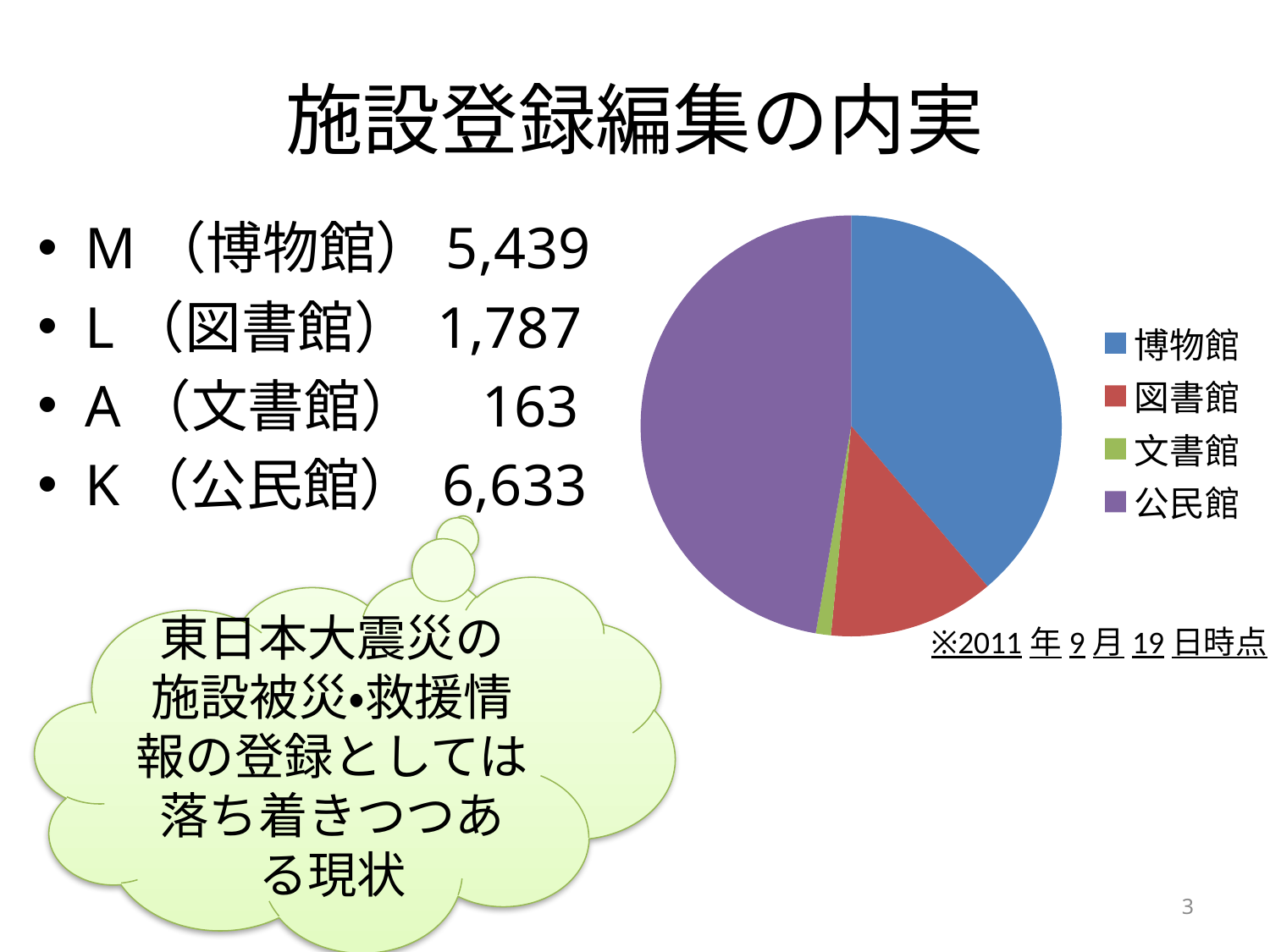
What is the total of the four values shown for the pie chart? 14,022 What colour is the 公民館 slice in the pie chart? purple How many categories does the pie chart's legend list? 4 According to the slide, what is the value for 図書館 (L)? 1,787 What kind of chart is shown on the slide? pie chart Which is larger, the slice for 博物館 or the slice for 図書館? 博物館 Which category has the largest slice in the pie chart? 公民館 According to the slide, what is the value for 博物館 (M)? 5,439 What is the difference between the values for 公民館 and 博物館? 1,194 According to the slide, what is the value for 公民館 (K)? 6,633 According to the slide, what is the value for 文書館 (A)? 163 Which category has the smallest slice in the pie chart? 文書館